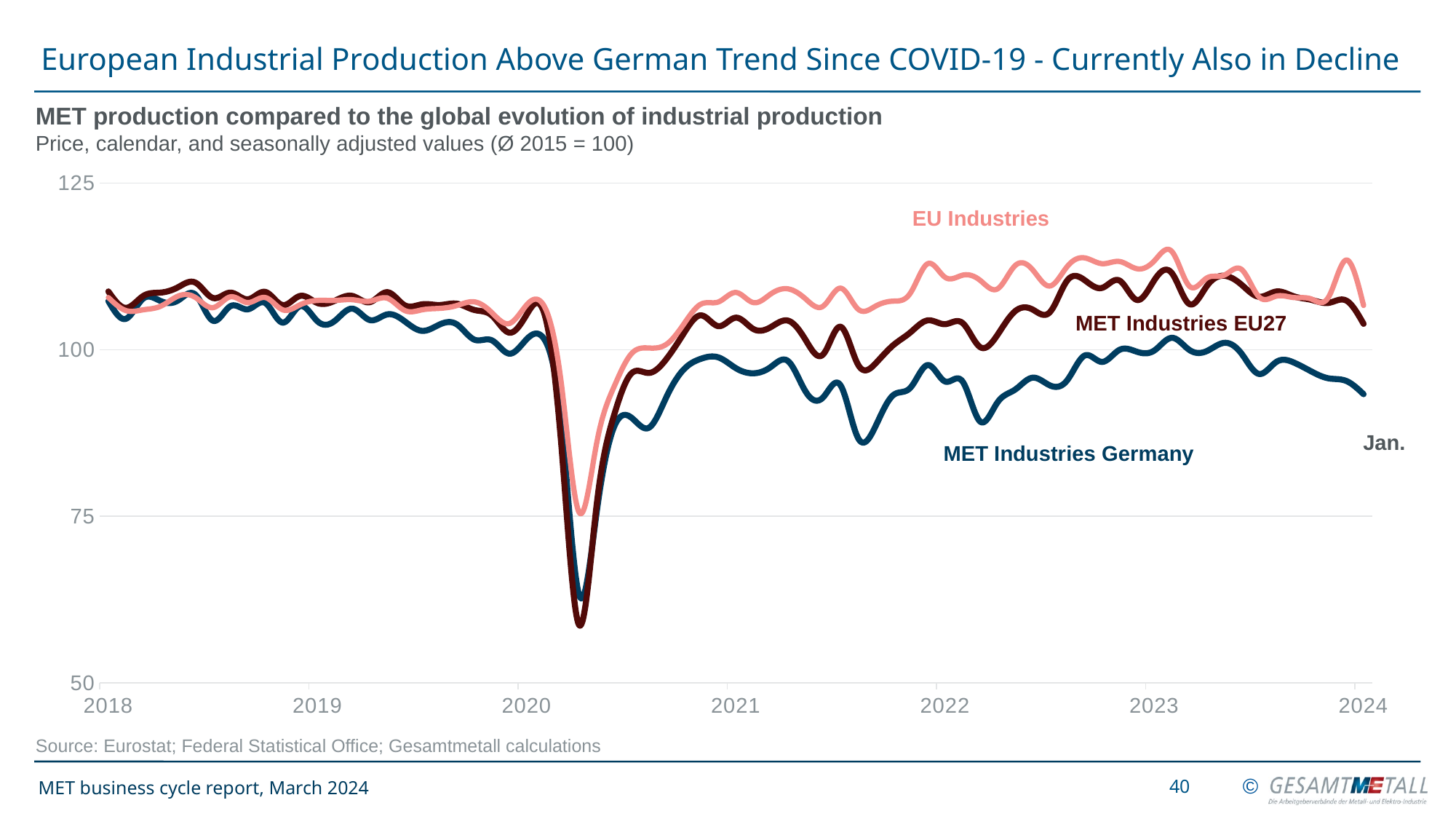
In January 2024, which is higher: EU Industries or MET Industries Germany? EU Industries Which series has the shallowest dip during 2020? EU Industries Is the value for EU Industries in January 2024 greater or less than 100? greater What kind of chart is shown on the slide? line chart What is the chart's title? MET production compared to the global evolution of industrial production Is the lowest value of MET Industries EU27 in 2020 greater or less than 75? less Is the value for MET Industries Germany in January 2024 greater or less than 100? less How many series are plotted on the chart? 3 Which series is labelled in pink on the chart? EU Industries How many year labels are shown on the x axis? 7 Does MET Industries Germany rise or fall between early 2023 and January 2024? fall